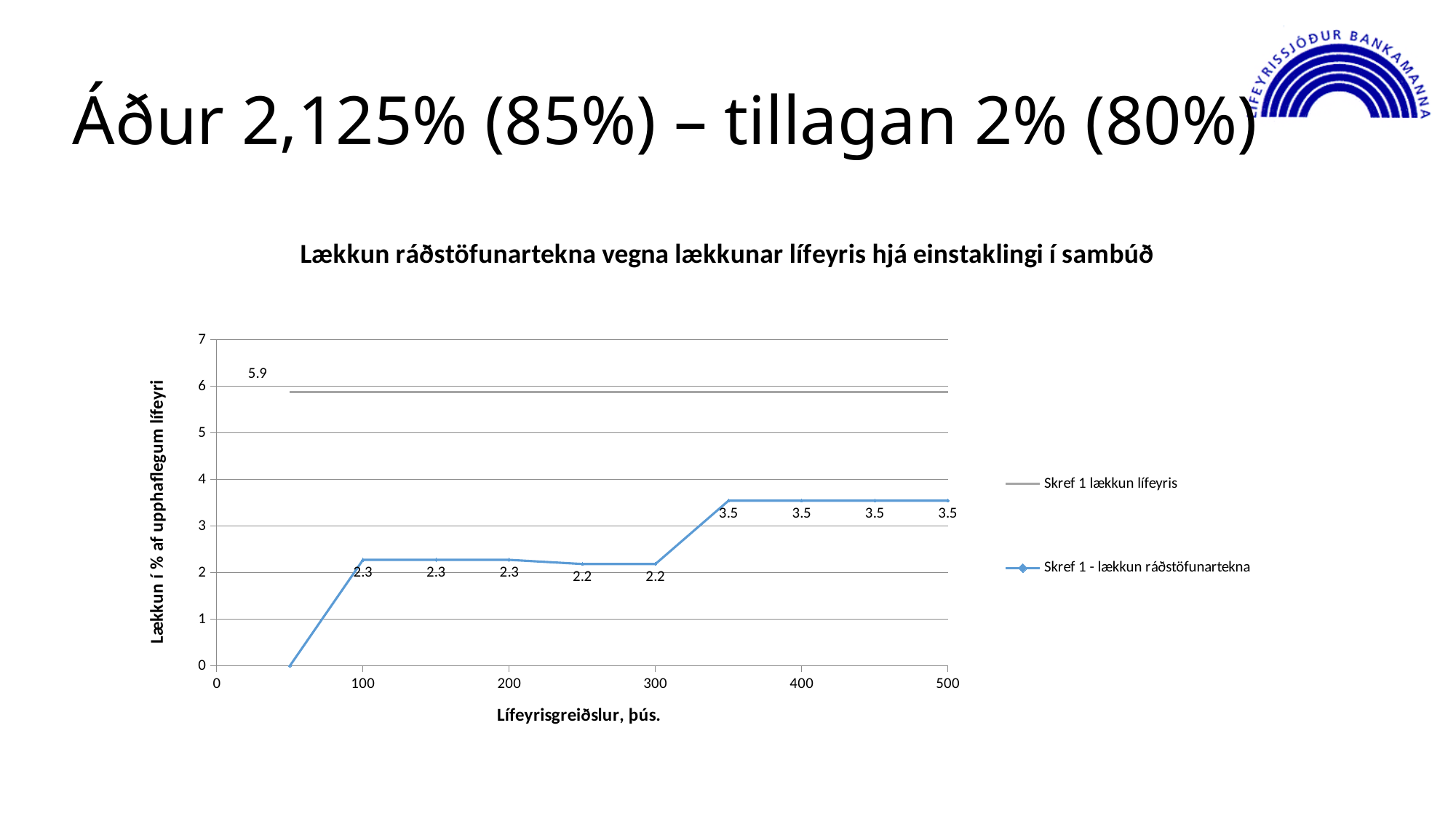
What is the value of the 'Skref 1 - lækkun ráðstöfunartekna' series at 250 on the x axis? 2.2 What is the value of the 'Skref 1 - lækkun ráðstöfunartekna' series at 400 on the x axis? 3.5 What is the value of the 'Skref 1 - lækkun ráðstöfunartekna' series at 100 on the x axis? 2.3 What is the difference between the 'Skref 1 lækkun lífeyris' value (5.9) and the 'Skref 1 - lækkun ráðstöfunartekna' value at 500? 2.4 What is the label of the x axis? Lífeyrisgreiðslur, þús. What is the difference between the 'Skref 1 - lækkun ráðstöfunartekna' values at 350 and at 300? 1.3 How many series does the legend list? 2 Which series has the higher value at 200 on the x axis: 'Skref 1 lækkun lífeyris' or 'Skref 1 - lækkun ráðstöfunartekna'? Skref 1 lækkun lífeyris What value is labelled on the 'Skref 1 lækkun lífeyris' line? 5.9 What kind of chart is shown on the slide? Line chart Is the value of 'Skref 1 - lækkun ráðstöfunartekna' at 450 greater or less than 3? greater Does the 'Skref 1 - lækkun ráðstöfunartekna' series rise or fall between 300 and 350 on the x axis? Rise